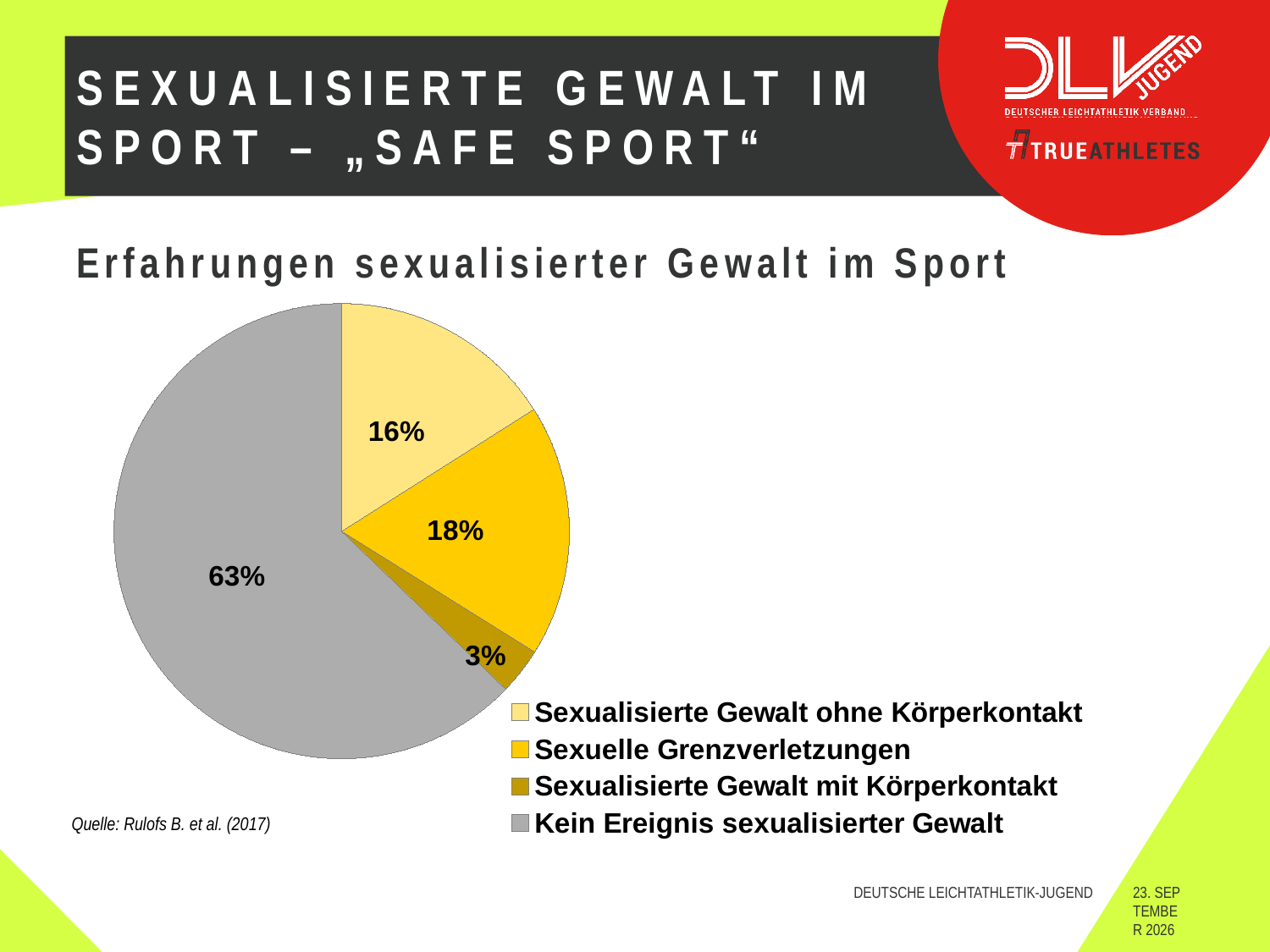
What share of the pie is labelled "Sexualisierte Gewalt ohne Körperkontakt"? 16% What share of the pie is labelled "Sexuelle Grenzverletzungen"? 18% How many categories does the pie chart have? 4 What colour is the slice for "Kein Ereignis sexualisierter Gewalt"? grey Which is larger: the slice for "Sexuelle Grenzverletzungen" or the slice for "Sexualisierte Gewalt mit Körperkontakt"? Sexuelle Grenzverletzungen Which category has the largest slice of the pie? Kein Ereignis sexualisierter Gewalt What share of the pie is labelled "Sexualisierte Gewalt mit Körperkontakt"? 3% What is the difference in percentage points between "Sexuelle Grenzverletzungen" and "Sexualisierte Gewalt ohne Körperkontakt"? 2 percentage points What kind of chart is shown on the slide? pie chart What is the title shown above the pie chart? Erfahrungen sexualisierter Gewalt im Sport What share of the pie is labelled "Kein Ereignis sexualisierter Gewalt"? 63% Which category has the smallest slice of the pie? Sexualisierte Gewalt mit Körperkontakt